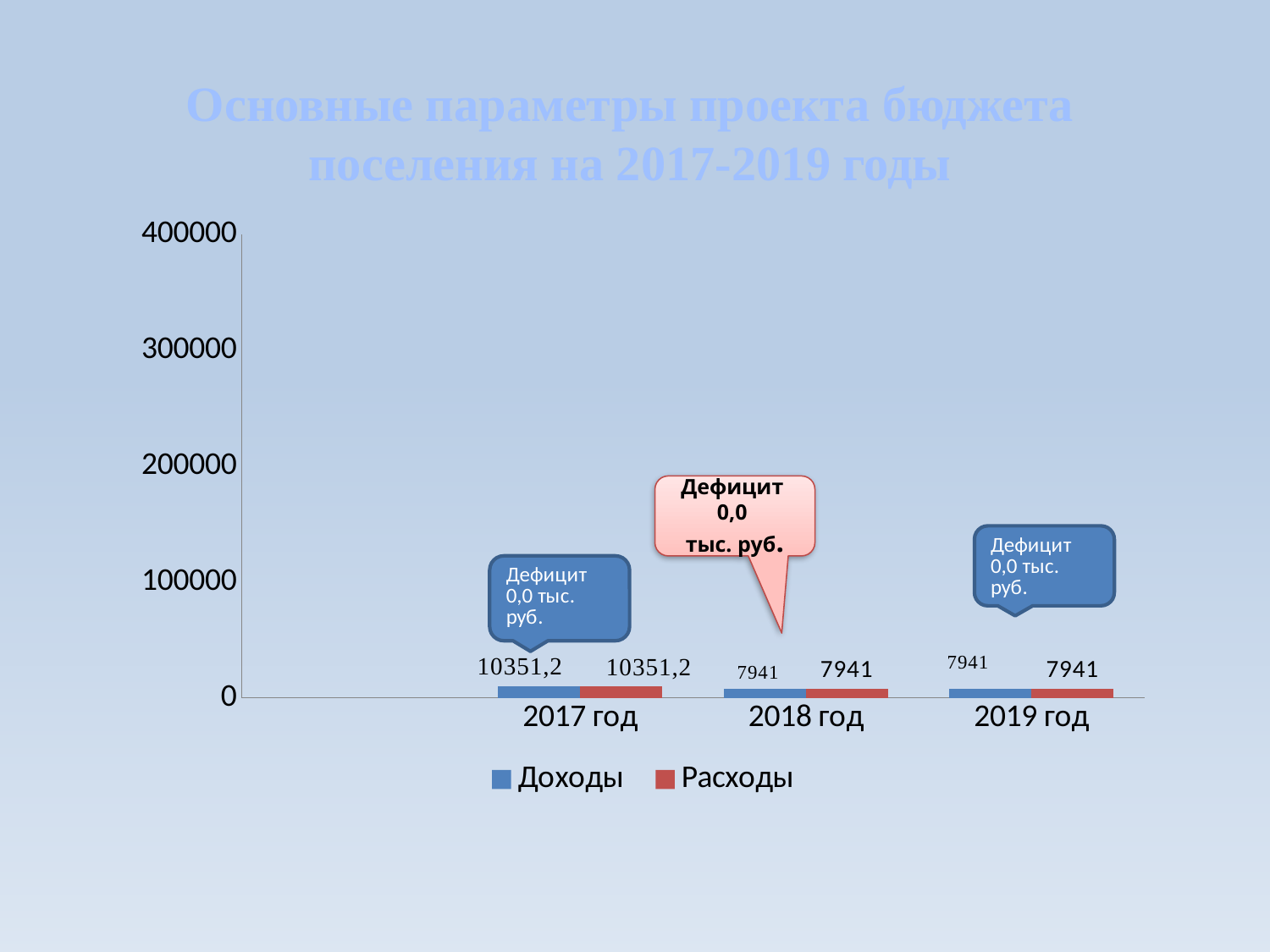
What deficit amount do the callouts on the chart state for each year? 0,0 тыс. руб. What kind of chart is shown on the slide? bar chart Which year has the highest value for Расходы? 2017 год What is the value of Расходы for 2018 год? 7941 What is the difference between Доходы in 2017 год and Доходы in 2018 год? 2410,2 How many years are shown on the x axis? 3 What is the value of Доходы for 2017 год? 10351,2 What are the two series listed in the legend? Доходы, Расходы Is the value of Доходы for 2017 год greater or less than 100000? less Do the values of Доходы rise or fall from 2017 год to 2018 год? fall How many series does the legend list? 2 What is the value of Доходы for 2019 год? 7941